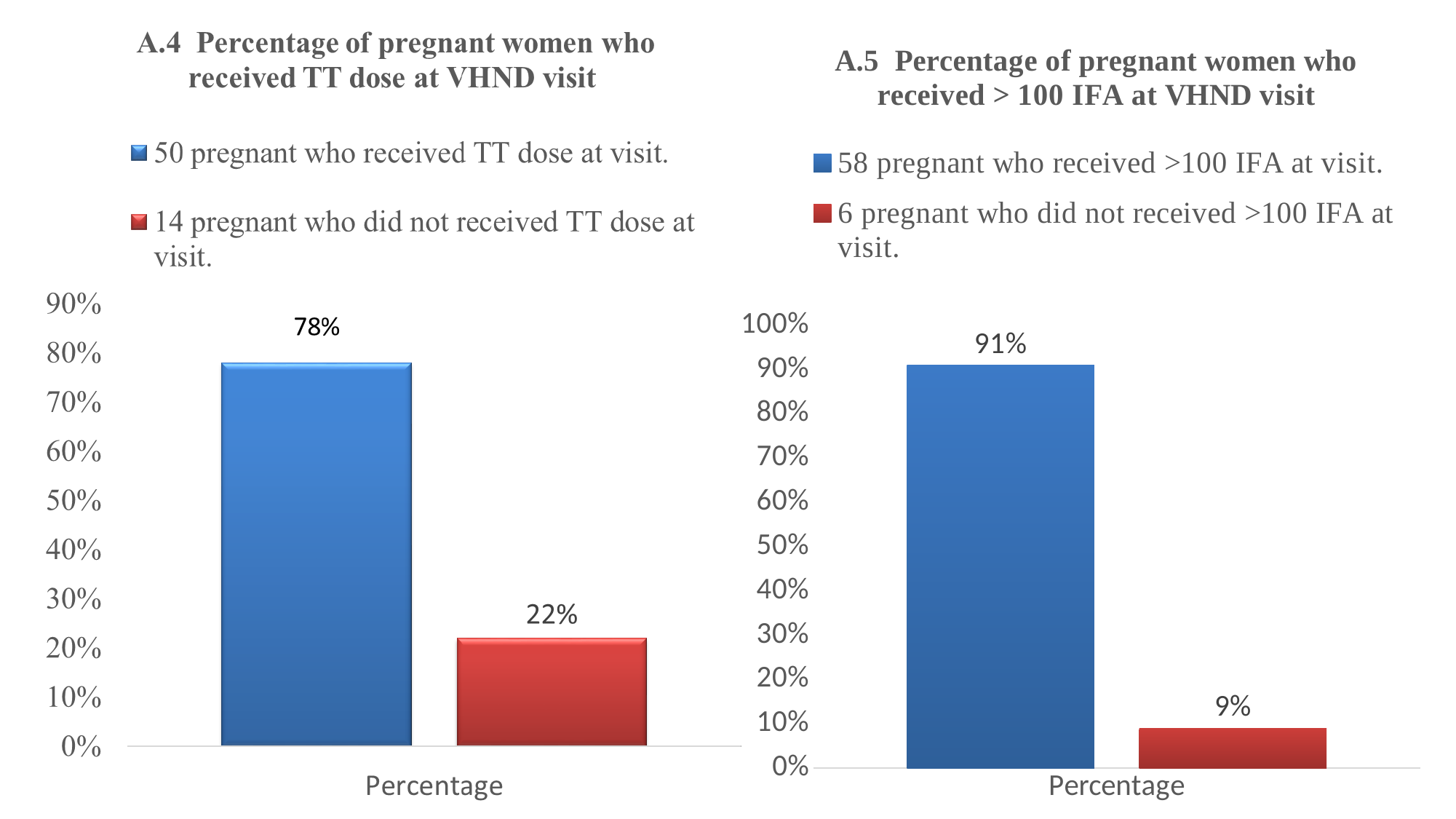
In the A.5 chart (Percentage of pregnant women who received > 100 IFA at VHND visit), what percentage is shown for the 58 pregnant who received >100 IFA at visit? 91% In the A.5 chart, what percentage is shown for the 6 pregnant who did not receive >100 IFA at visit? 9% Is the value for the red bar in the A.4 chart greater or less than 30%? less In the A.4 chart, which series has the higher value? 50 pregnant who received TT dose at visit. What colour is the bar for the 58 pregnant who received >100 IFA at visit in the A.5 chart? blue In the A.4 chart (Percentage of pregnant women who received TT dose at VHND visit), what percentage is shown for the 50 pregnant who received TT dose at visit? 78% What kind of chart is the A.4 chart? bar chart How many series does the legend of the A.5 chart list? 2 In the A.4 chart, what is the difference between the percentage who received the TT dose and the percentage who did not? 56% In the A.5 chart, which series has the lower value? 6 pregnant who did not received >100 IFA at visit. In the A.4 chart, what percentage is shown for the 14 pregnant who did not receive TT dose at visit? 22% In the A.5 chart, what is the difference between the percentage who received >100 IFA and the percentage who did not? 82%